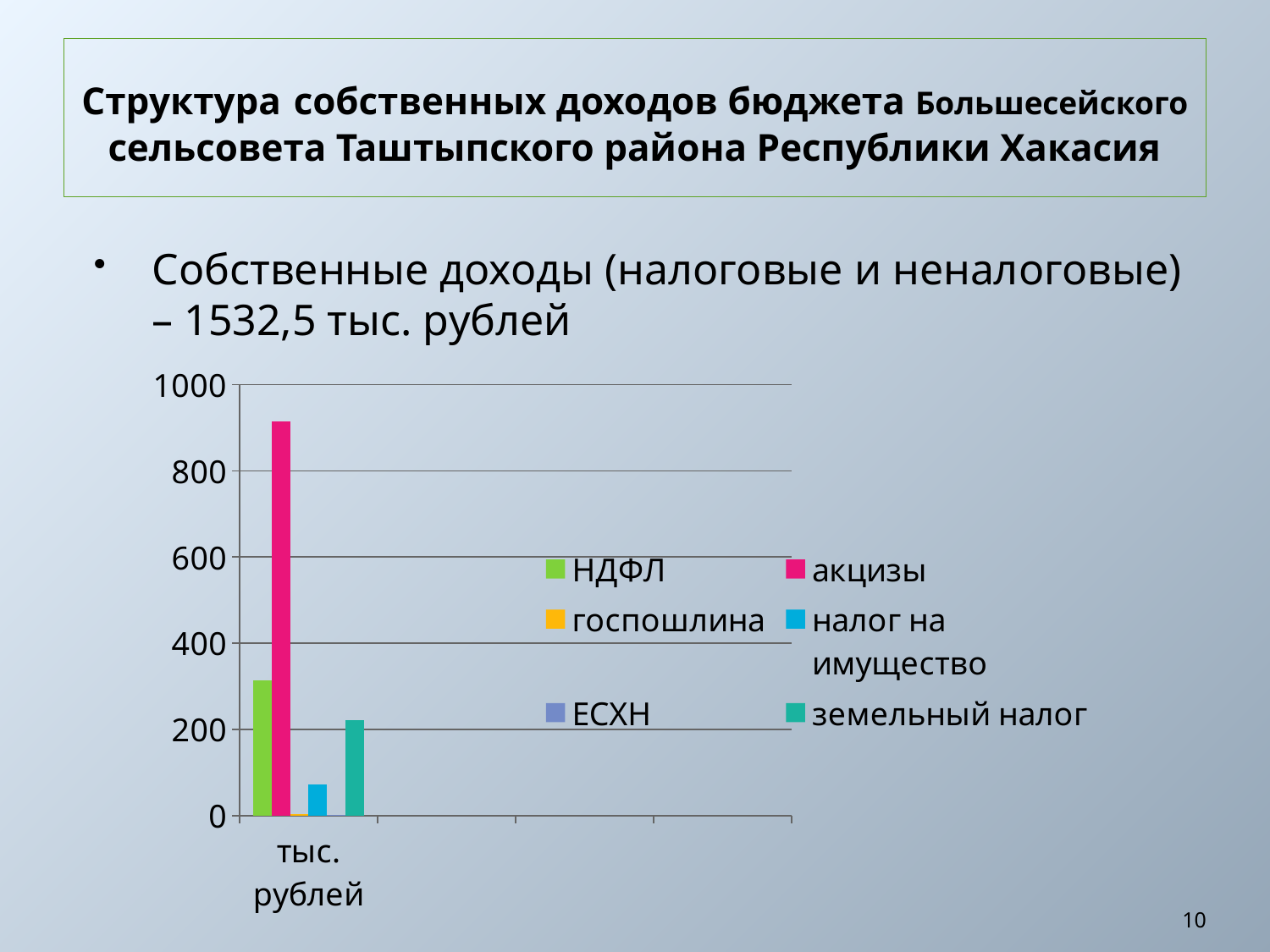
Is the value for акцизы greater or less than 800? greater What label appears under the group of bars on the horizontal axis? тыс. рублей Which is larger, the value for НДФЛ or the value for земельный налог? НДФЛ Is the value for земельный налог greater or less than 200? greater What kind of chart is shown on the slide? bar chart Is the value for налог на имущество greater or less than 200? less What is the highest value shown on the vertical axis of the chart? 1000 Which is larger, the value for налог на имущество or the value for земельный налог? земельный налог How many series does the chart legend list? 6 Which series has the tallest bar in the chart? акцизы